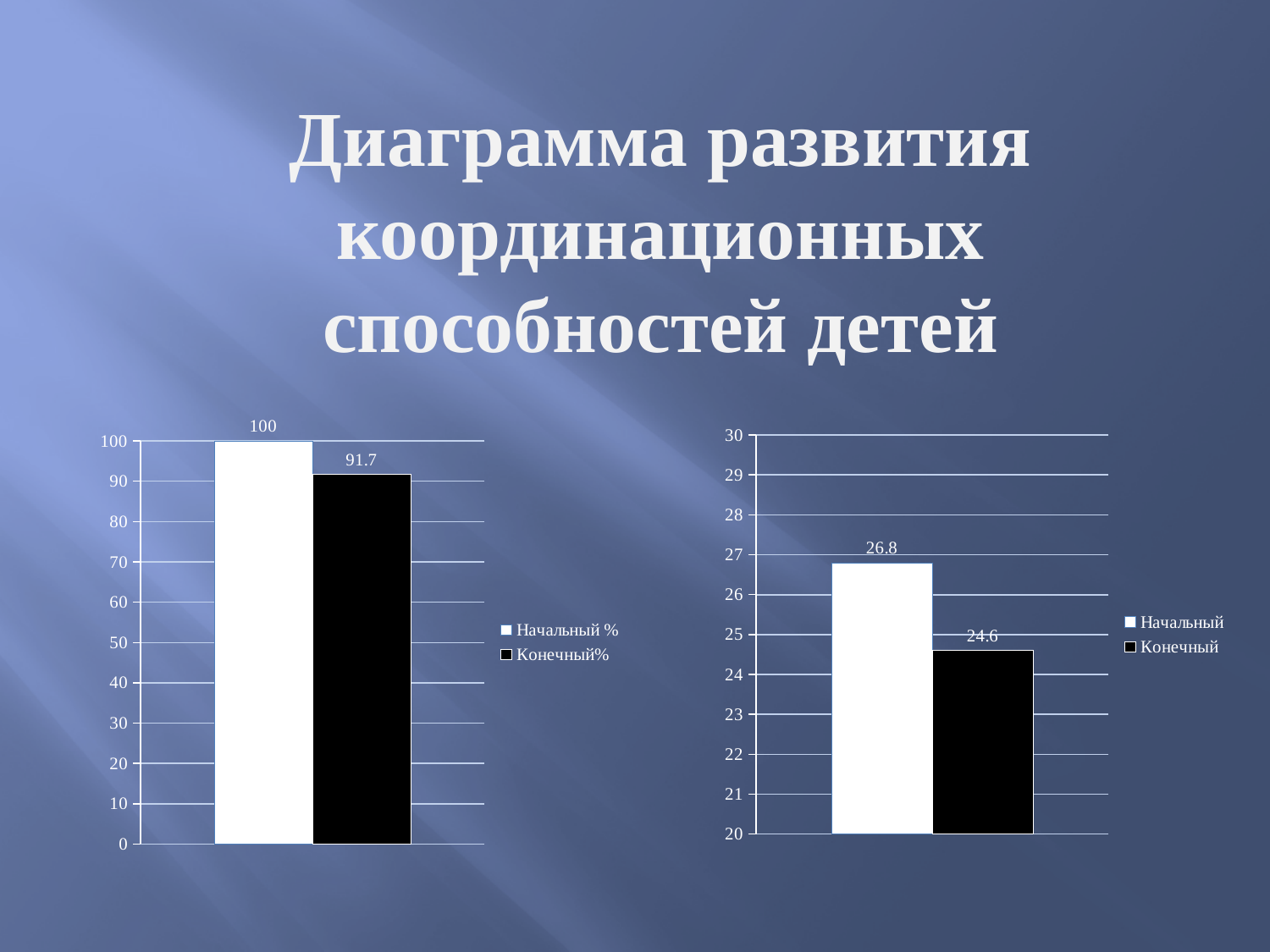
On the right chart, which series has the highest value? Начальный On the left chart, which series has the lowest value? Конечный% On the left chart, what is the difference between Начальный % and Конечный%? 8.3 On the right chart, what is the value for Начальный? 26.8 On the left chart, what is the value for Начальный %? 100 On the left chart, what is the value for Конечный%? 91.7 On the right chart, what is the value for Конечный? 24.6 On the right chart, which is larger, Начальный or Конечный? Начальный How many series does the legend of the right chart list? 2 On the right chart, what is the difference between Начальный and Конечный? 2.2 What kind of chart is the left chart? bar chart On the right chart, what colour is the bar for Конечный? black